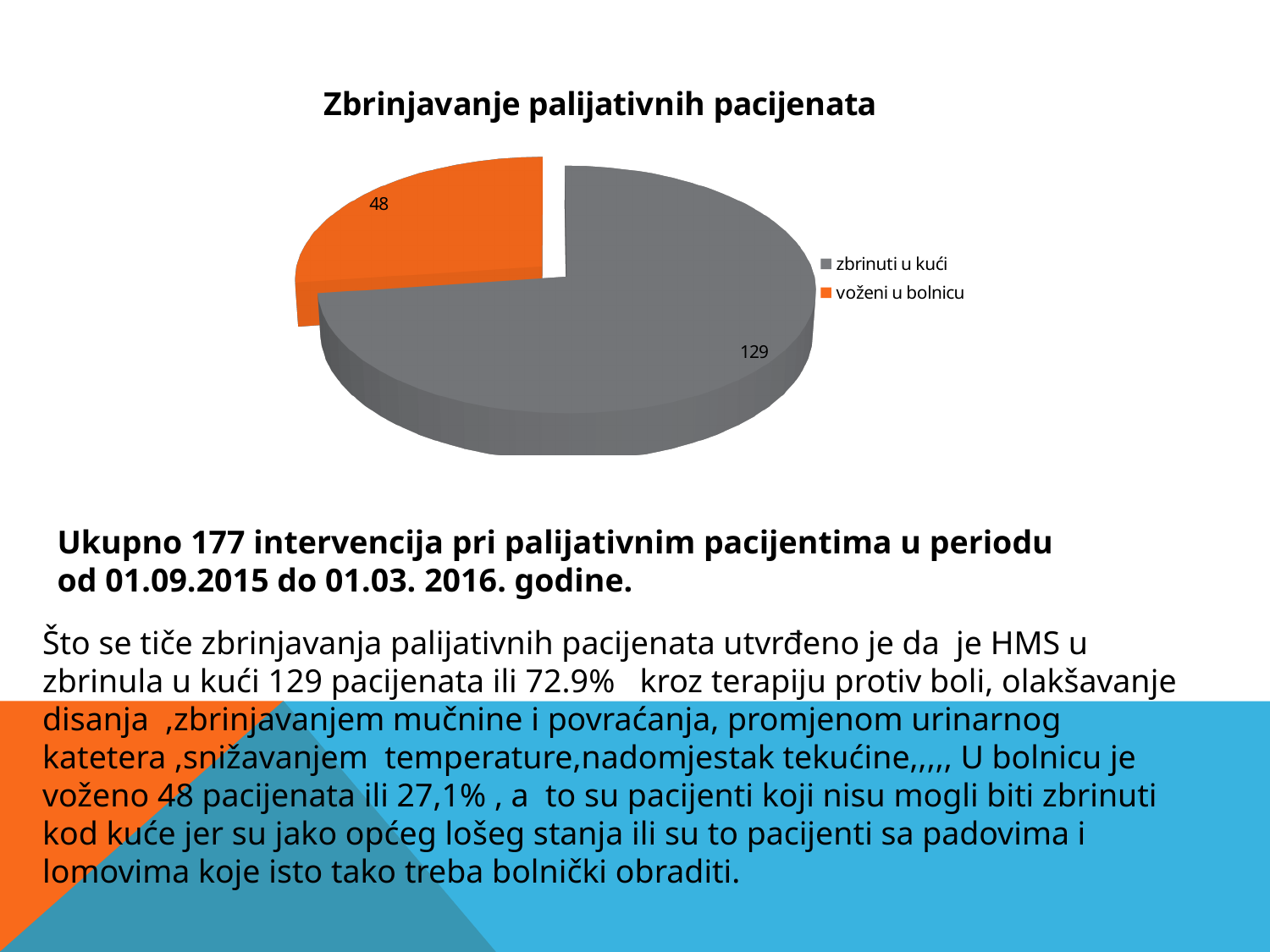
What is the title of the chart? Zbrinjavanje palijativnih pacijenata What type of chart is shown on the slide? pie chart Which category has the largest slice of the pie? zbrinuti u kući What share of the pie does 'zbrinuti u kući' represent? 72.9% What is the value for 'voženi u bolnicu'? 48 Which is larger, the value for 'zbrinuti u kući' or for 'voženi u bolnicu'? zbrinuti u kući Which colour represents 'voženi u bolnicu' in the legend? orange What is the total of all slices in the pie chart? 177 What is the difference between the values for 'zbrinuti u kući' and 'voženi u bolnicu'? 81 Which category has the smallest slice of the pie? voženi u bolnicu How many slices does the pie chart have? 2 What is the value for 'zbrinuti u kući'? 129